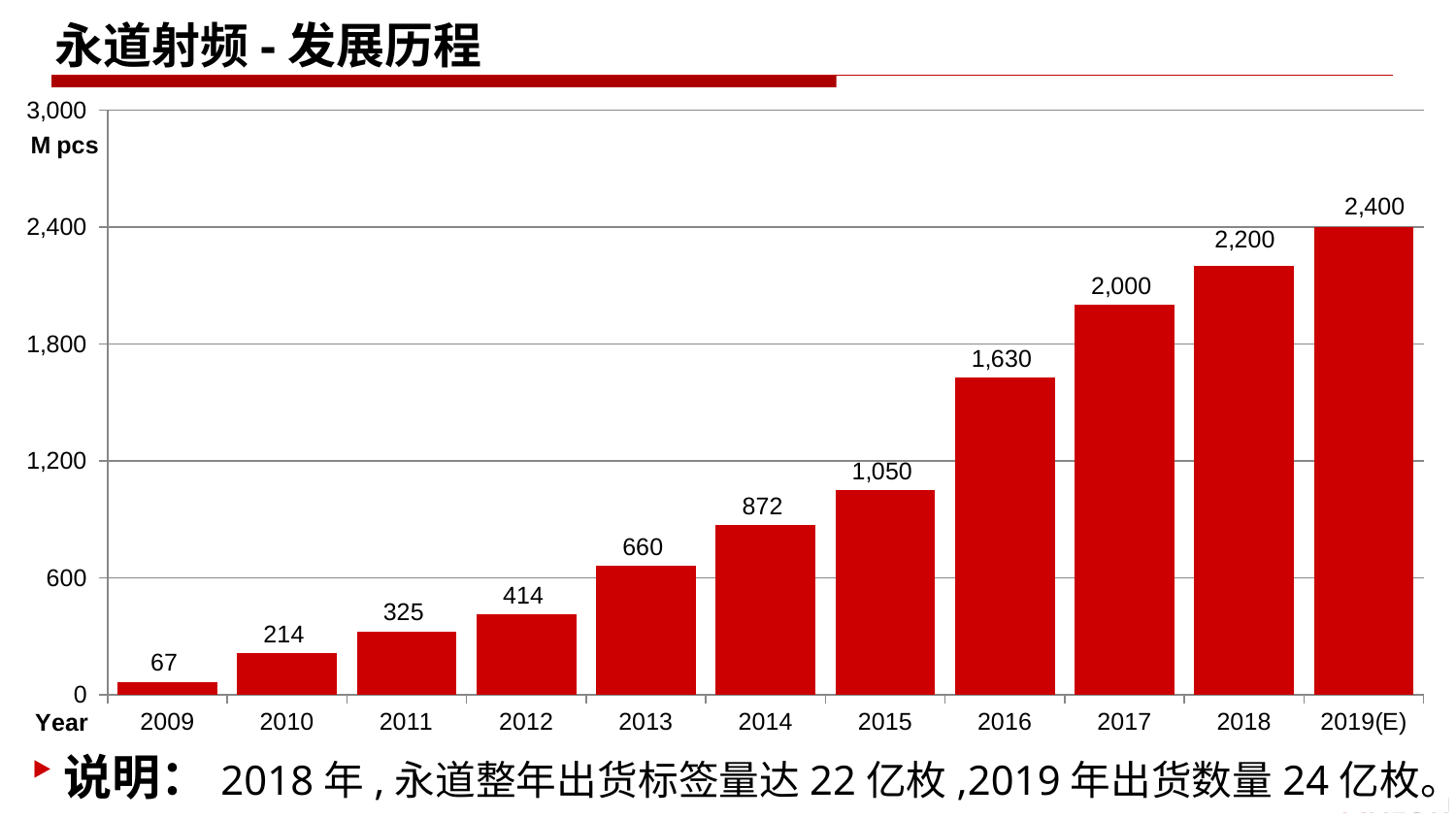
What kind of chart is this? bar chart What is the value for 2014? 872 What is the value for 2009? 67 How many years are shown on the x axis? 11 Do the values rise or fall from 2009 to 2019(E)? rise Which year has the lowest value? 2009 Which year has the highest value? 2019(E) What unit is shown on the y axis? M pcs What is the difference between the values for 2018 and 2017? 200 What is the value for 2019(E)? 2,400 Which is larger, the value for 2012 or the value for 2013? 2013 What is the difference between the values for 2016 and 2015? 580